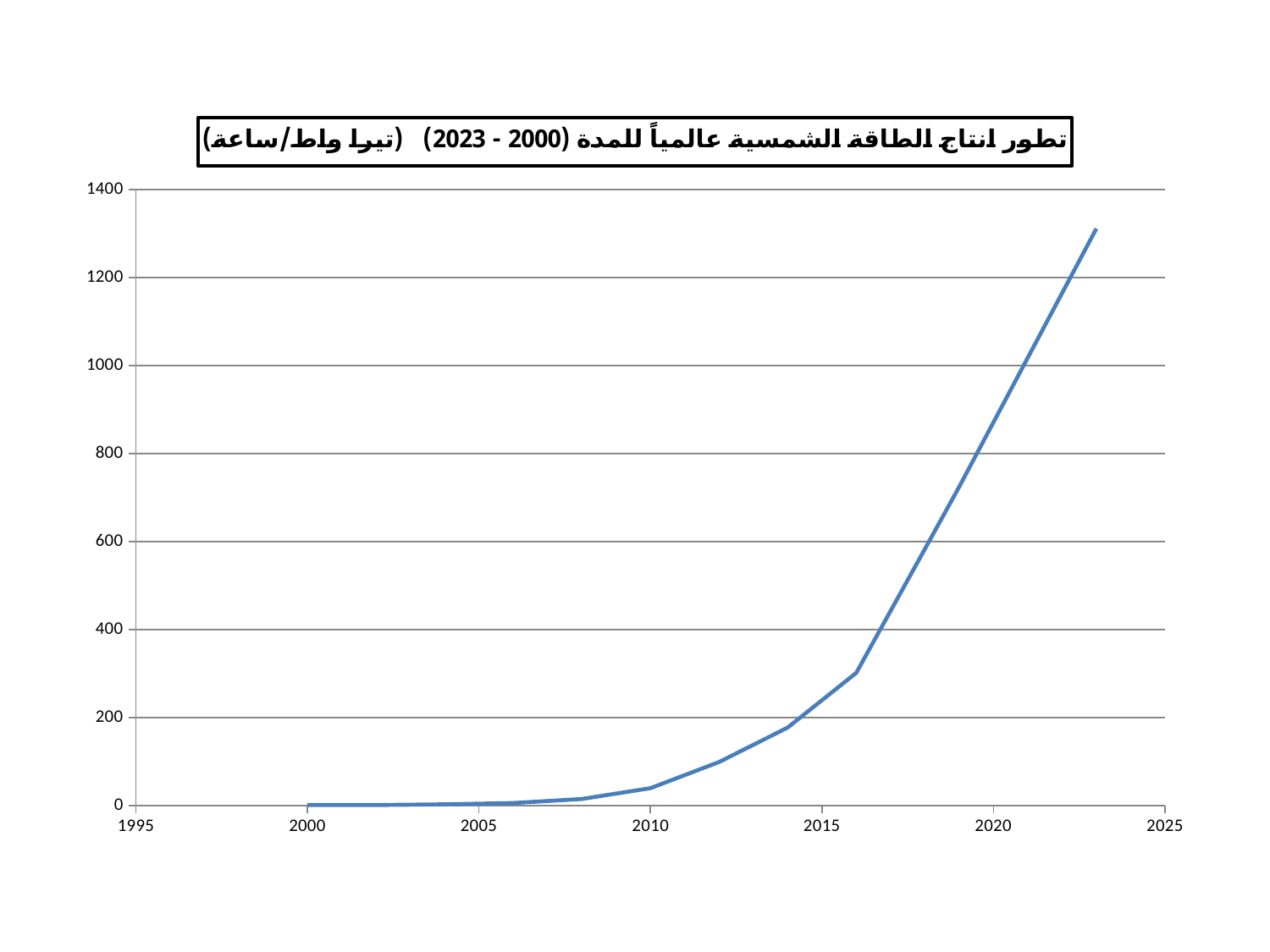
What kind of chart is shown on the slide? line chart Is the value for 2023 greater or less than 1200? greater Is the value for 2016 greater or less than 200? greater What is the highest value shown on the vertical axis? 1400 Do the values generally rise or fall from 2000 to 2023? rise Is the value for 2010 greater or less than 200? less Which year has the highest value on the chart? 2023 Which is larger, the value for 2016 or the value for 2023? 2023 What period does the chart title say the data covers? 2000 - 2023